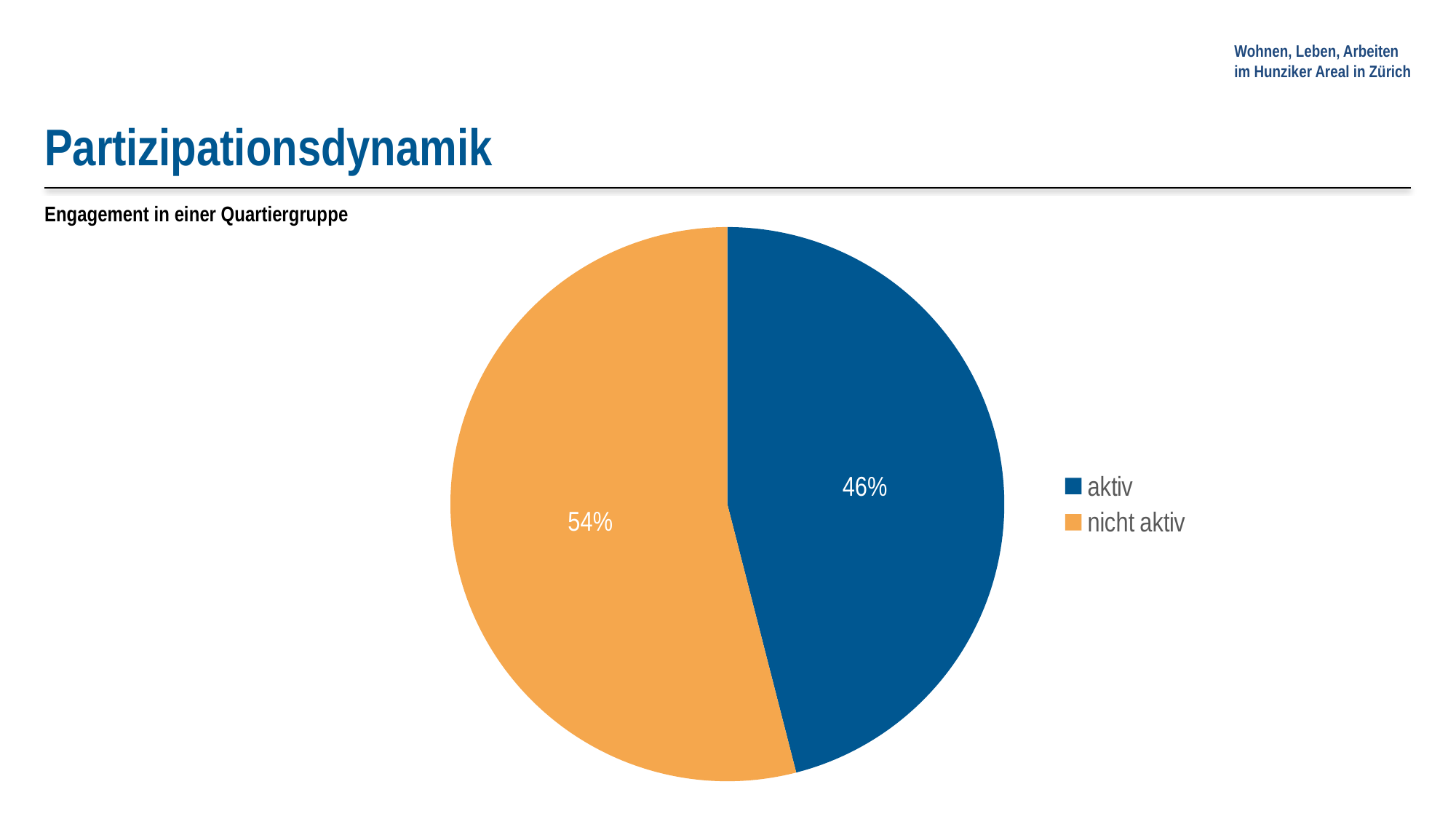
What is the difference in percentage points between the "nicht aktiv" and "aktiv" slices? 8 What is the subtitle shown above the chart? Engagement in einer Quartiergruppe What colour is the "nicht aktiv" slice? orange How many entries does the legend list? 2 What kind of chart is shown on the slide? pie chart What share of the pie is labelled "nicht aktiv"? 54% Which is larger, the "aktiv" slice or the "nicht aktiv" slice? nicht aktiv Which slice of the pie is the smallest? aktiv What is the share of the "aktiv" slice of the pie? 46% Which slice of the pie is the largest? nicht aktiv How many slices does the pie chart have? 2 What share of the pie is labelled "aktiv"? 46%